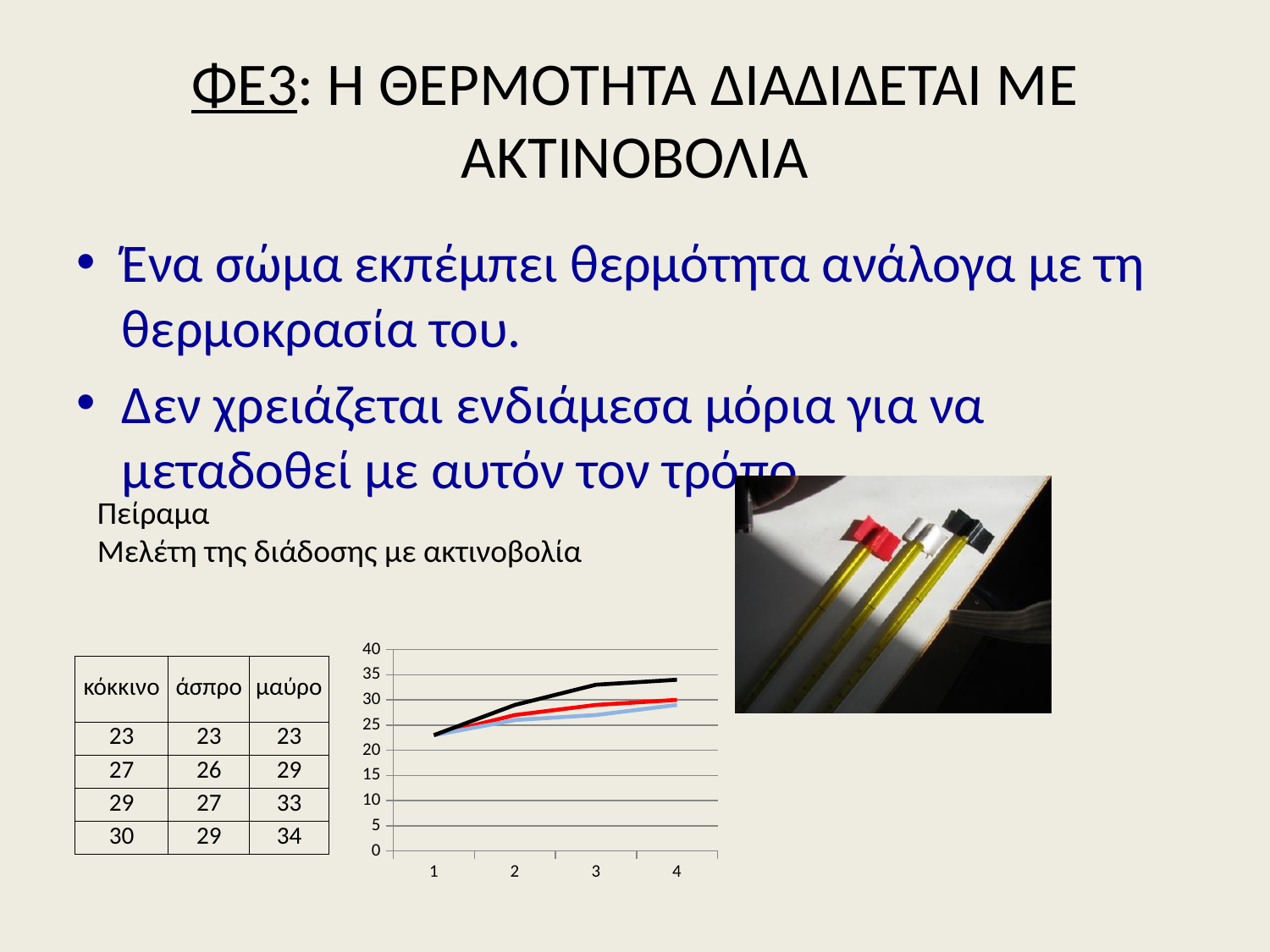
Are the values of all three lines at x = 1 greater or less than 25? less Is the value of the black line at x = 4 greater or less than 30? greater Is the value of the red line at x = 2 greater or less than 25? greater What is the highest tick value shown on the y axis of the line chart? 40 Do the values in the line chart rise or fall from x = 1 to x = 4? rise What kind of chart is shown on the slide? line chart Which line is highest at x = 4 in the line chart? the black line At x = 3, which is larger: the black line or the blue line? the black line How many points are plotted along the x axis of the line chart? 4 How many lines are plotted in the line chart? 3